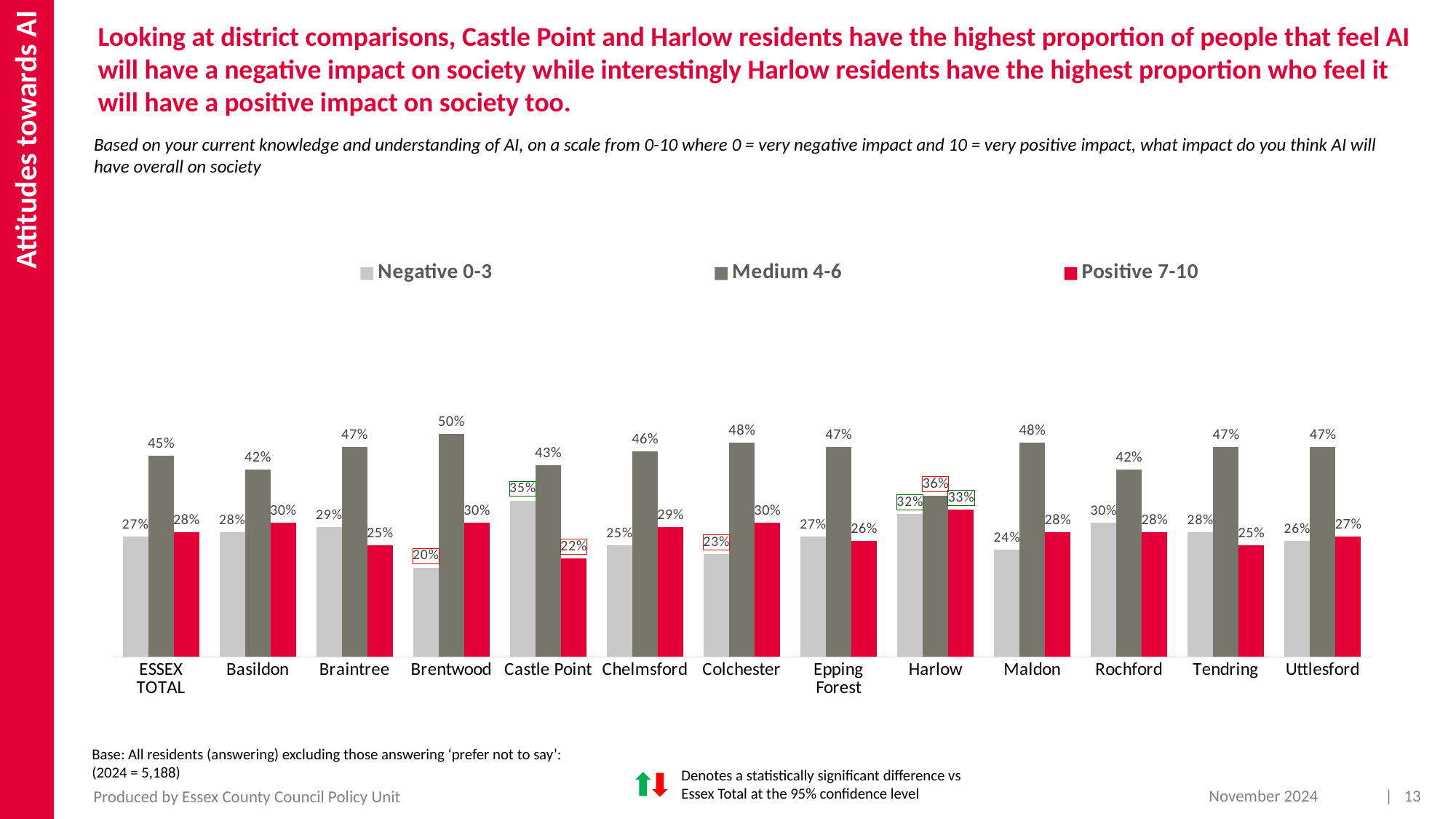
What is the Negative 0-3 value for Castle Point? 35% What is the difference between the Medium 4-6 value for Brentwood and the Medium 4-6 value for Harlow? 14% Which district has the lowest Negative 0-3 value? Brentwood Which district has the highest Medium 4-6 value? Brentwood What is the Positive 7-10 value for ESSEX TOTAL? 28% Which district has the lowest Positive 7-10 value? Castle Point How many categories are shown on the x axis? 13 What is the Medium 4-6 value for Brentwood? 50% How many series does the legend list? 3 What is the Positive 7-10 value for Harlow? 33% What kind of chart is shown on the slide? Bar chart Which is larger: the Negative 0-3 value for Castle Point or the Negative 0-3 value for Colchester? Castle Point